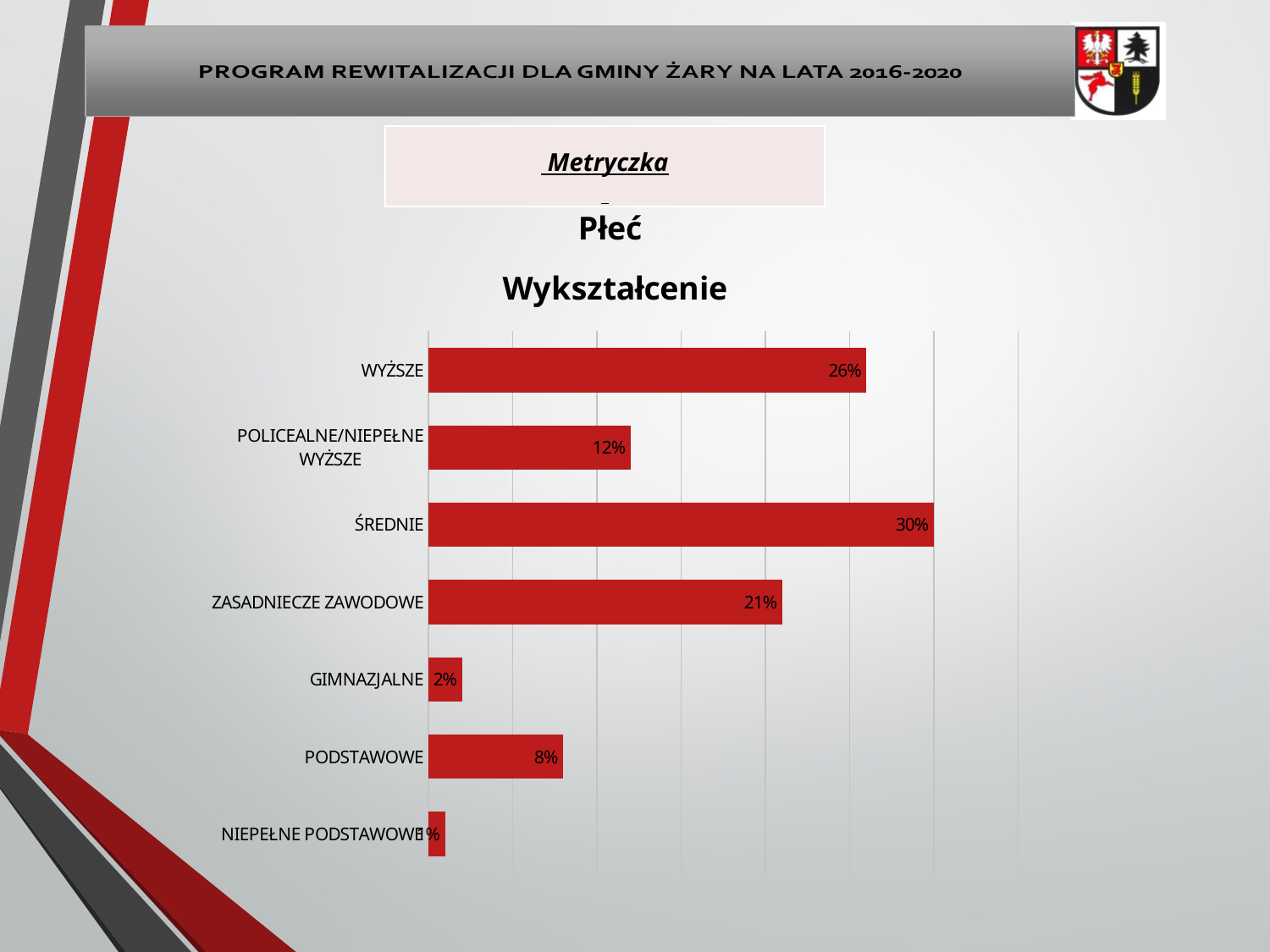
What kind of chart is the Wykształcenie chart? Bar chart What is the value for ŚREDNIE in the Wykształcenie chart? 30% Which category has the lowest value in the Wykształcenie chart? NIEPEŁNE PODSTAWOWE What is the value for POLICEALNE/NIEPEŁNE WYŻSZE in the Wykształcenie chart? 12% Which is larger in the Wykształcenie chart, ZASADNIECZE ZAWODOWE or POLICEALNE/NIEPEŁNE WYŻSZE? ZASADNIECZE ZAWODOWE What is the title of the chart on the slide? Wykształcenie Which category has the highest value in the Wykształcenie chart? ŚREDNIE What is the value for WYŻSZE in the Wykształcenie chart? 26% What is the difference between the values for ŚREDNIE and WYŻSZE in the Wykształcenie chart? 4% What is the value for ZASADNIECZE ZAWODOWE in the Wykształcenie chart? 21% What is the value for PODSTAWOWE in the Wykształcenie chart? 8% How many categories are shown in the Wykształcenie chart? 7